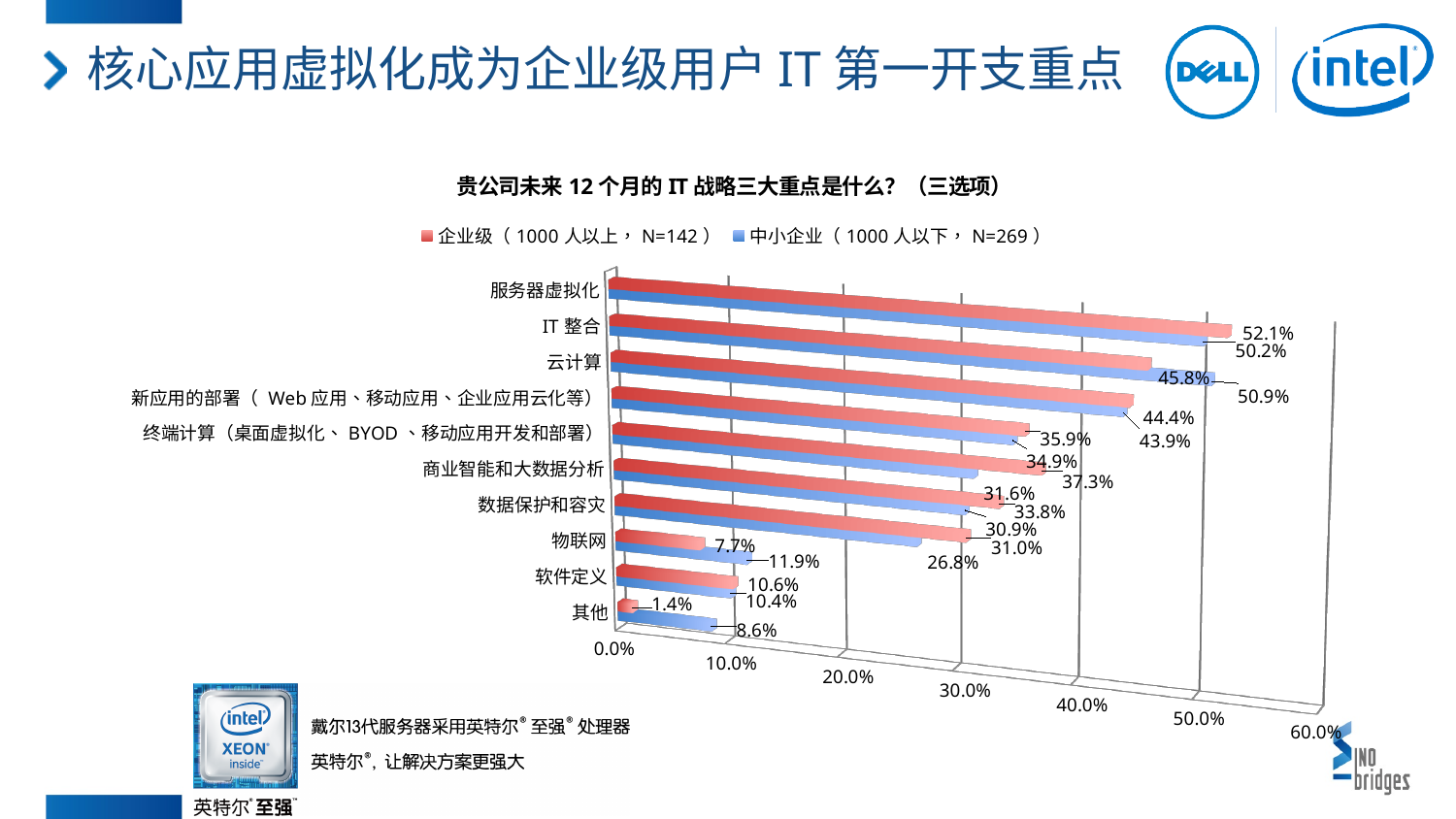
Which category has the highest value in the 企业级 series? 服务器虚拟化 How many series does the legend list? 2 For IT 整合, which series has the larger value, 企业级 or 中小企业? 中小企业 How many categories are plotted on the chart? 10 Which category has the lowest value in the 企业级 series? 其他 What is the difference between the 企业级 and 中小企业 values for 服务器虚拟化? 1.9% What sample size (N) does the legend give for the 企业级 series? N=142 What is the value for 服务器虚拟化 in the 企业级 series? 52.1% What is the value for 其他 in the 企业级 series? 1.4% What is the value for IT 整合 in the 中小企业 series? 50.9% What is the value for 服务器虚拟化 in the 中小企业 series? 50.2% What kind of chart is shown on the slide? bar chart